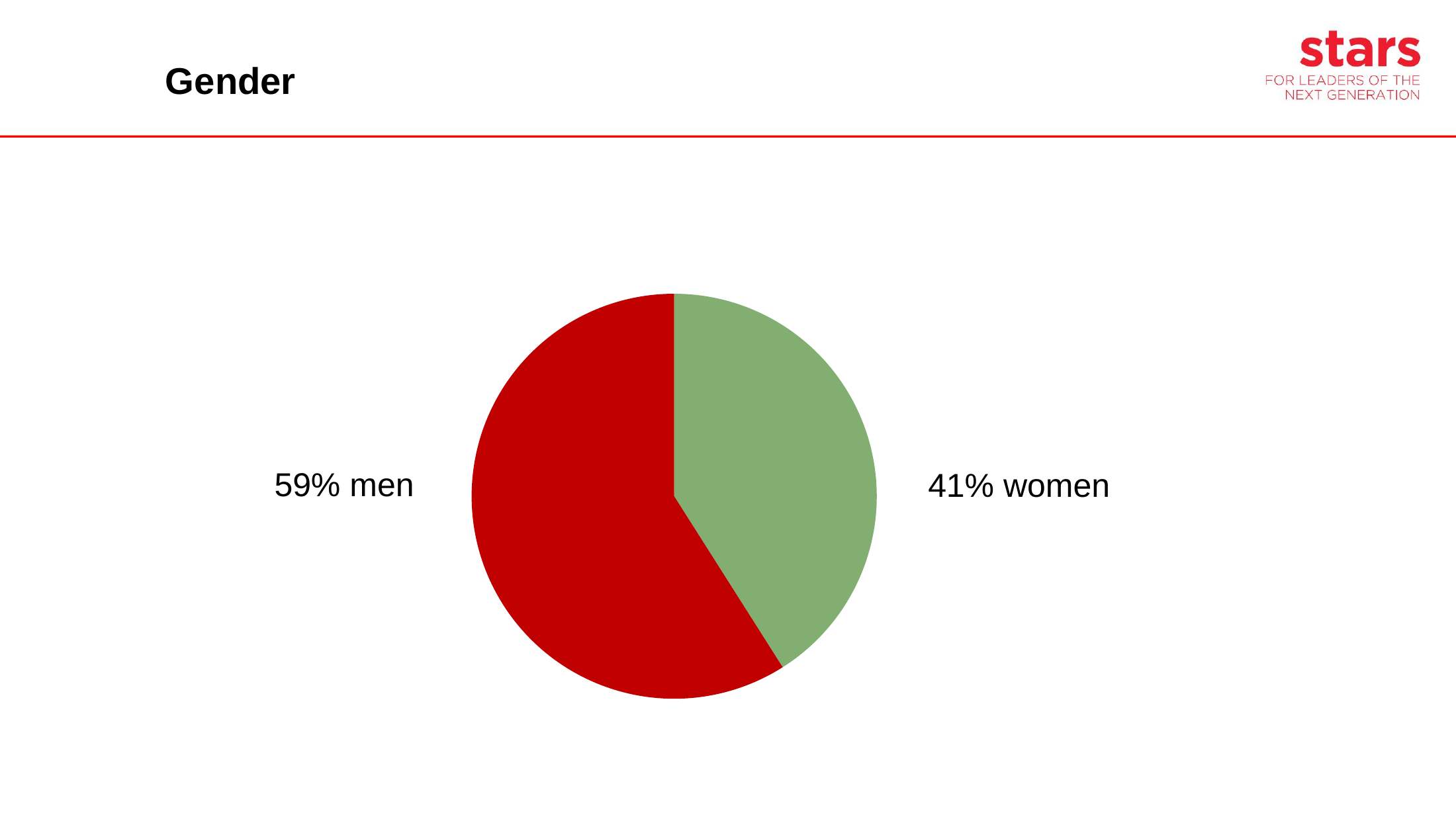
Which category has the largest share? men What is the title of the slide? Gender What share of the pie is women? 41% How many slices does the pie chart have? 2 Which slice is larger, men or women? men What colour is the slice representing women? green What type of chart is shown on the slide? pie chart What is the difference in percentage points between the men and women shares? 18 What share of the pie is men? 59% Is the share for men greater or less than 50%? greater Which category has the smallest share? women